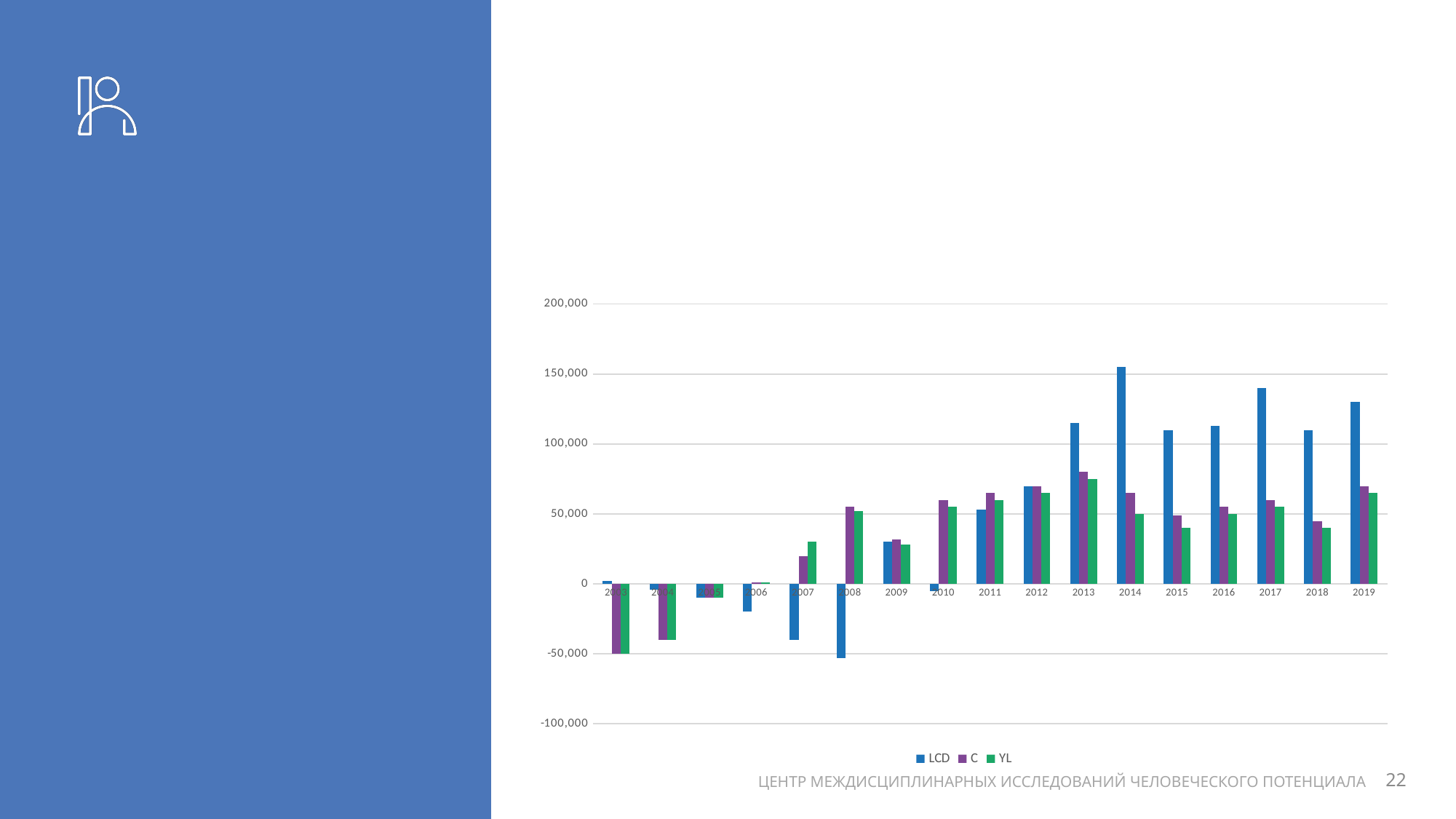
How many years are shown along the x axis? 17 Does the LCD value rise or fall from 2010 to 2014? rise In which year is the LCD value highest? 2014 In 2014, which is larger, the LCD value or the C value? LCD In which year is the LCD value lowest? 2008 What are the series names listed in the legend? LCD, C, YL Which series has the highest value in 2019? LCD What kind of chart is shown on the slide? bar chart Is the LCD value for 2014 greater or less than 100,000? greater Is the LCD value for 2007 greater or less than -50,000? greater Is the YL value for 2015 greater or less than 50,000? less How many series does the legend list? 3